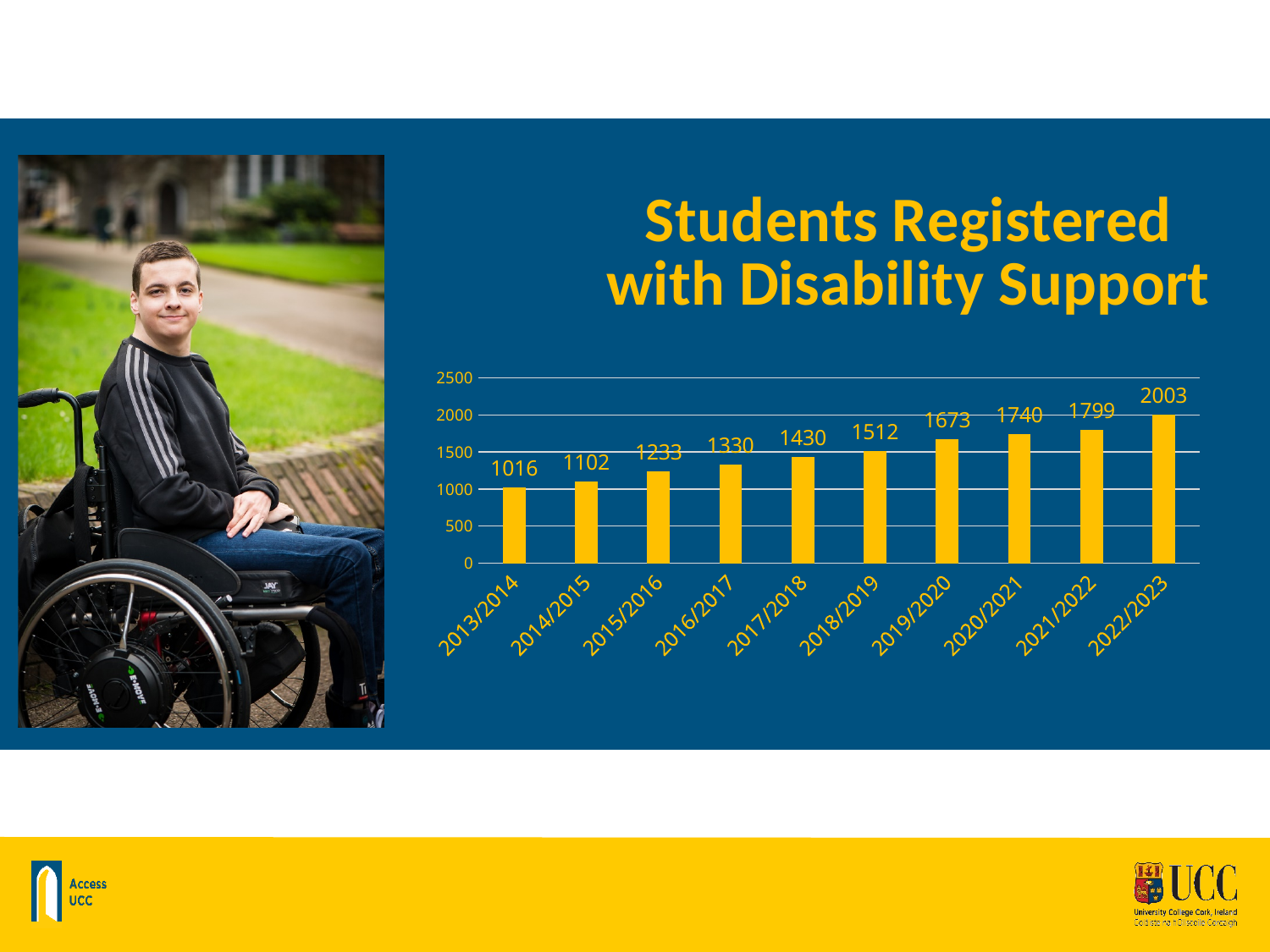
Which academic year has the lowest number of students registered? 2013/2014 Which is larger, the value for 2016/2017 or the value for 2017/2018? 2017/2018 Is the value for 2020/2021 greater or less than 1500? greater What is the value for 2013/2014? 1016 Do the values rise or fall from 2013/2014 to 2022/2023? rise What is the value for 2022/2023? 2003 Which academic year has the highest number of students registered? 2022/2023 How many academic years are shown on the chart? 10 What is the difference between the values for 2022/2023 and 2013/2014? 987 What is the value for 2018/2019? 1512 What kind of chart is shown on the slide? bar chart What is the difference between the values for 2019/2020 and 2018/2019? 161